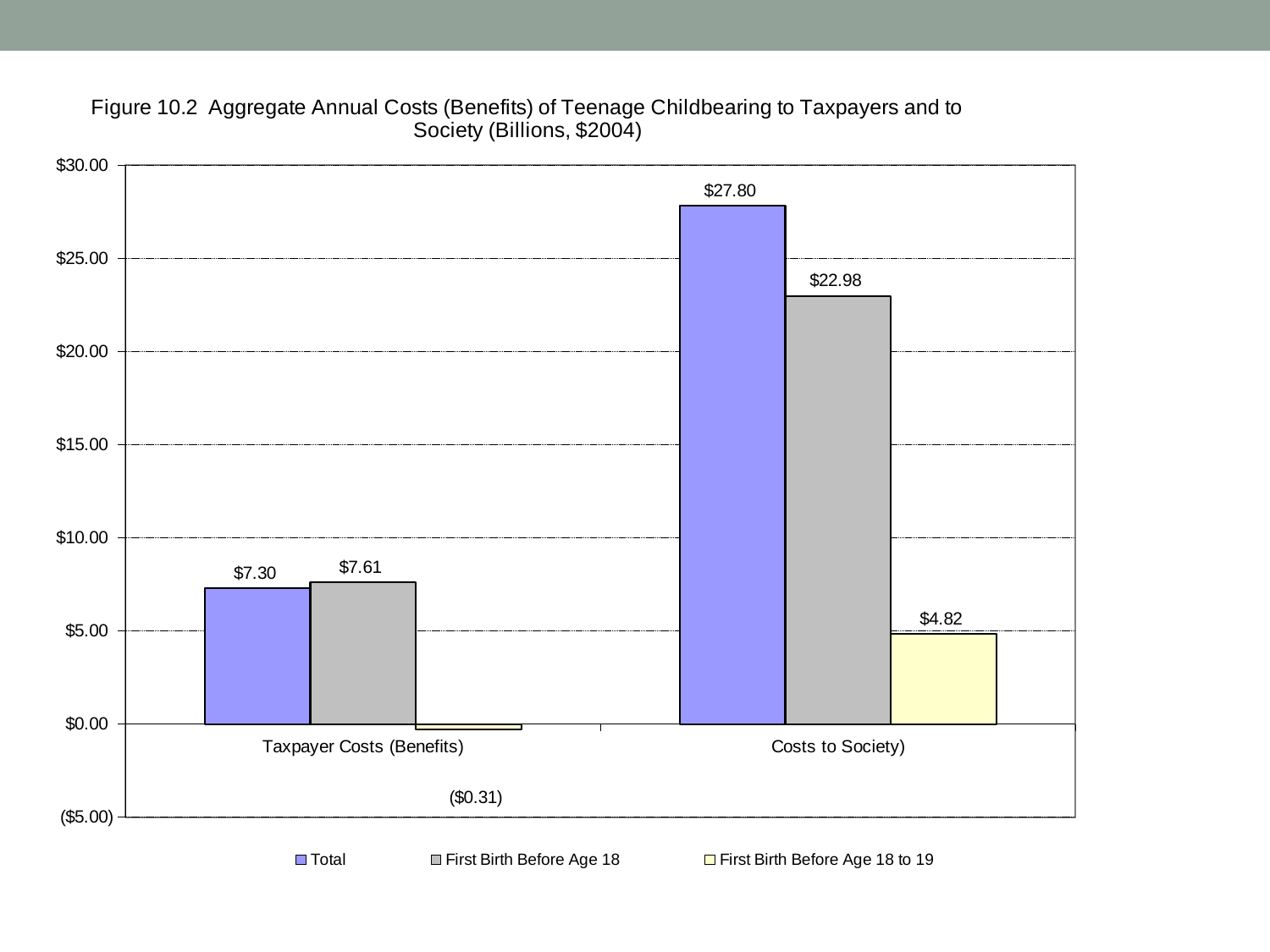
Is the First Birth Before Age 18 value for Costs to Society greater or less than $20.00? greater What is the Total value for Costs to Society? $27.80 Which series has the lowest value in the Taxpayer Costs (Benefits) category? First Birth Before Age 18 to 19 What is the value for First Birth Before Age 18 to 19 in the Costs to Society category? $4.82 Which is larger in the Costs to Society category: Total or First Birth Before Age 18? Total How many categories are shown on the x axis? 2 What kind of chart is shown on the slide? Bar chart Which series has the highest value in the Costs to Society category? Total How many series does the legend list? 3 What is the value for First Birth Before Age 18 to 19 in the Taxpayer Costs (Benefits) category? ($0.31) What is the value for First Birth Before Age 18 in the Taxpayer Costs (Benefits) category? $7.61 What is the difference between the Total value for Costs to Society and the Total value for Taxpayer Costs (Benefits)? $20.50